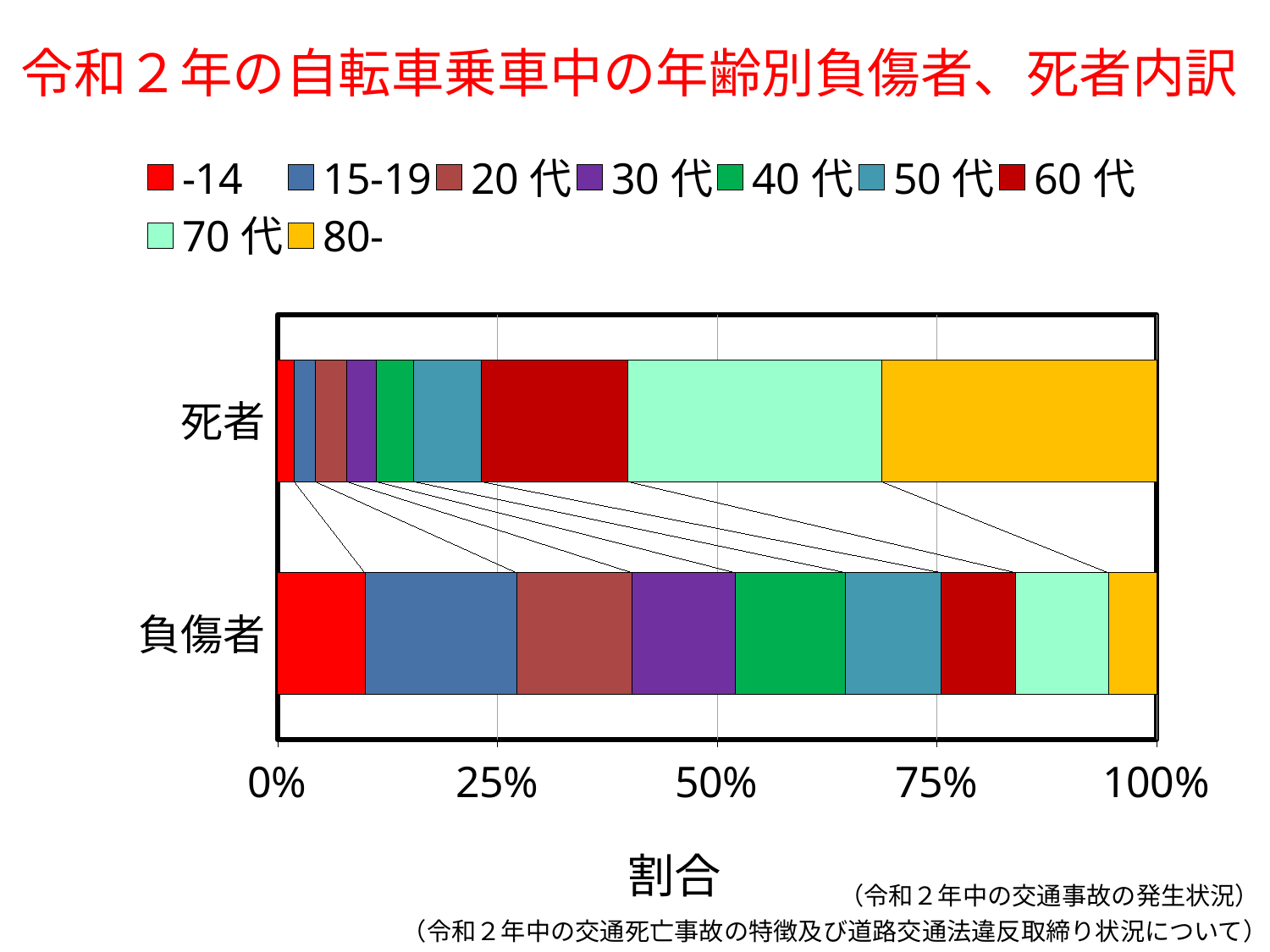
What is the label of the horizontal axis? 割合 How many series does the legend list? 9 In the 負傷者 bar, which age group has the smallest share? 80- Is the share of 15-19 larger in the 死者 bar or in the 負傷者 bar? 負傷者 Is the share of 70 代 in the 死者 bar greater or less than 25%? greater Is the share of 80- larger in the 死者 bar or in the 負傷者 bar? 死者 In the 死者 bar, which age group has the smallest share? -14 What kind of chart is shown on the slide? Stacked bar chart How many categories (bars) does the chart show? 2 Is the share of -14 in the 負傷者 bar greater or less than 25%? less In the 死者 bar, which age group has the largest share? 80- In the 負傷者 bar, which age group has the largest share? 15-19